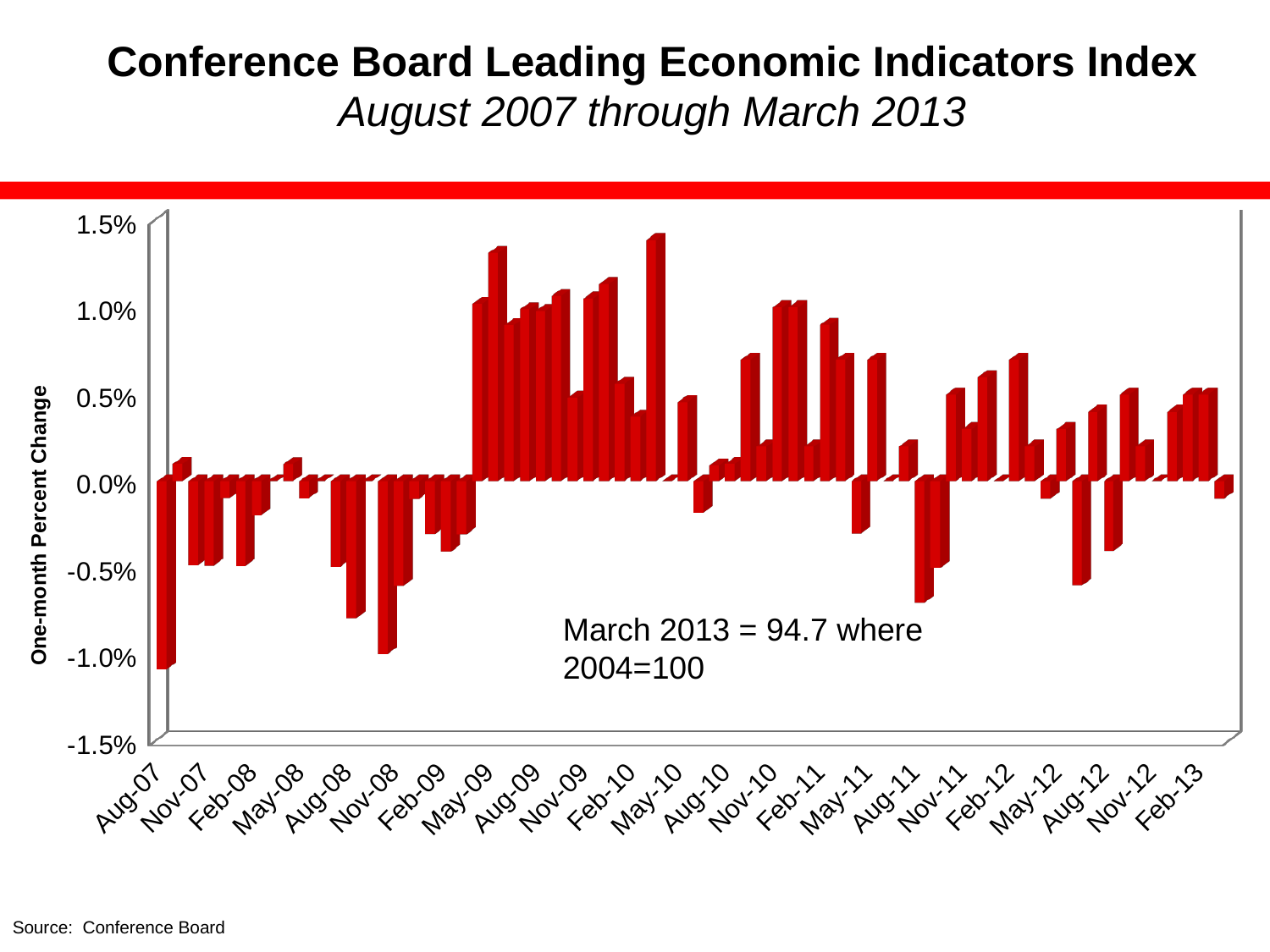
Is the value for Feb-13 greater or less than 0.0%? greater Is the value for May-09 greater or less than 0.5%? greater What is the label on the vertical axis of the chart? One-month Percent Change Which is larger, the value for Aug-07 or the value for May-09? May-09 According to the note on the chart, what is the index value for March 2013? 94.7 Is the value for Aug-07 greater or less than -0.5%? less What kind of chart is shown on the slide? bar chart